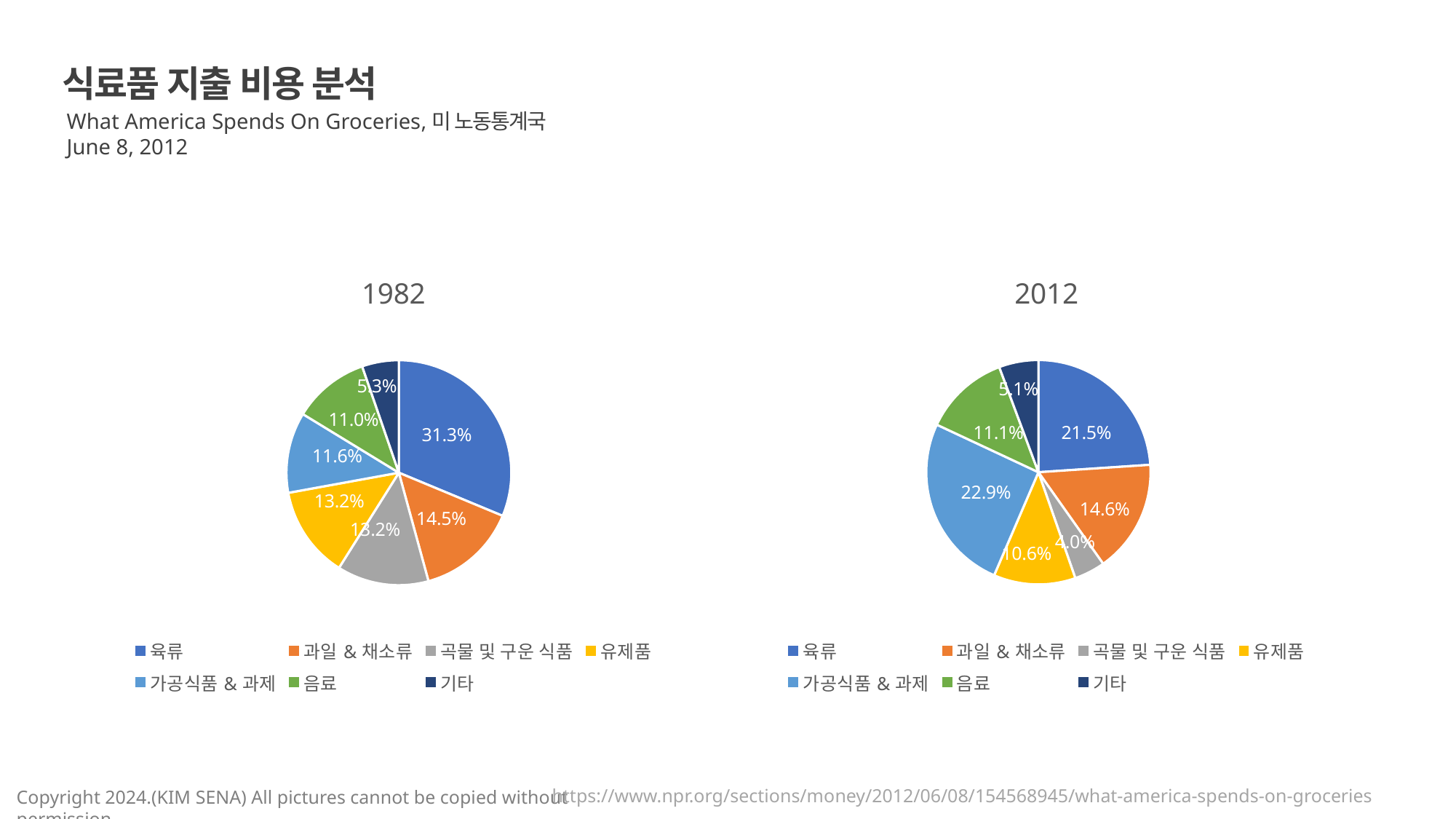
What is the difference between the 육류 share in the 1982 chart and the 육류 share in the 2012 chart? 9.8% In the 1982 pie chart, what share does 육류 have? 31.3% How many categories does the 1982 pie chart show? 7 In the 2012 pie chart, what share does 곡물 및 구운 식품 have? 4.0% In the 2012 pie chart, what share does 가공식품 & 과제 have? 22.9% In the 2012 pie chart, which is larger: 가공식품 & 과제 or 육류? 가공식품 & 과제 In the 1982 pie chart, which category has the smallest share? 기타 In the 2012 pie chart, what is the combined share of 음료 and 기타? 16.2% What type of chart is the 2012 chart? Pie chart In the 1982 pie chart, which category has the largest share? 육류 What colour represents 유제품 in the legends of both charts? Yellow In the 2012 pie chart, which category has the smallest share? 곡물 및 구운 식품